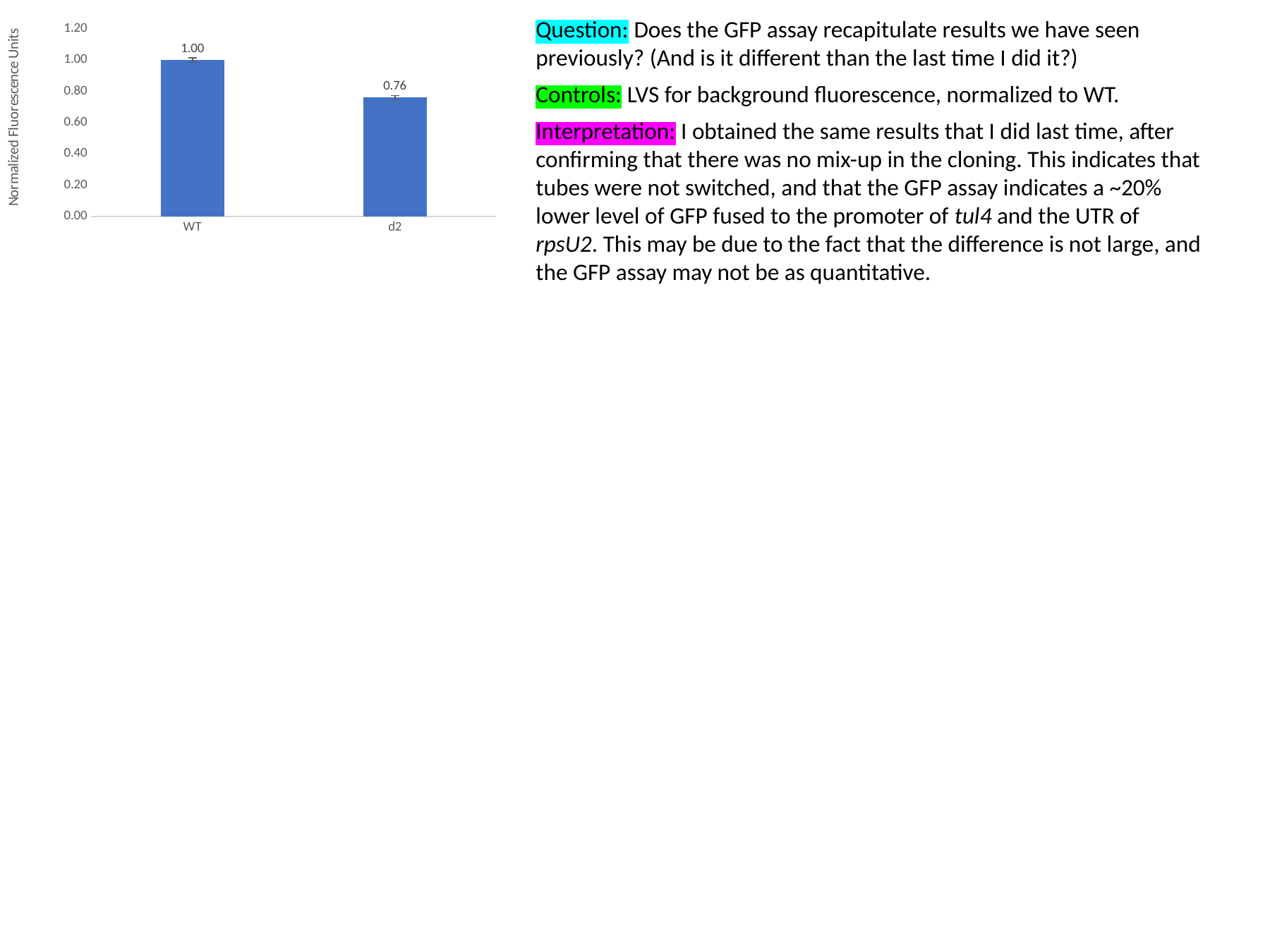
What is the normalized fluorescence value for WT? 1.00 What is the difference between the WT and d2 values? 0.24 Do the values rise or fall from WT to d2? fall What is the normalized fluorescence value for d2? 0.76 Is the value for d2 greater or less than 0.80? less Which is larger, the value for WT or the value for d2? WT What is the highest tick value shown on the y axis? 1.20 What kind of chart is shown on the slide? bar chart Which category has the highest normalized fluorescence? WT Which category has the lowest normalized fluorescence? d2 How many categories are shown on the x axis? 2 What is the label of the y axis? Normalized Fluorescence Units